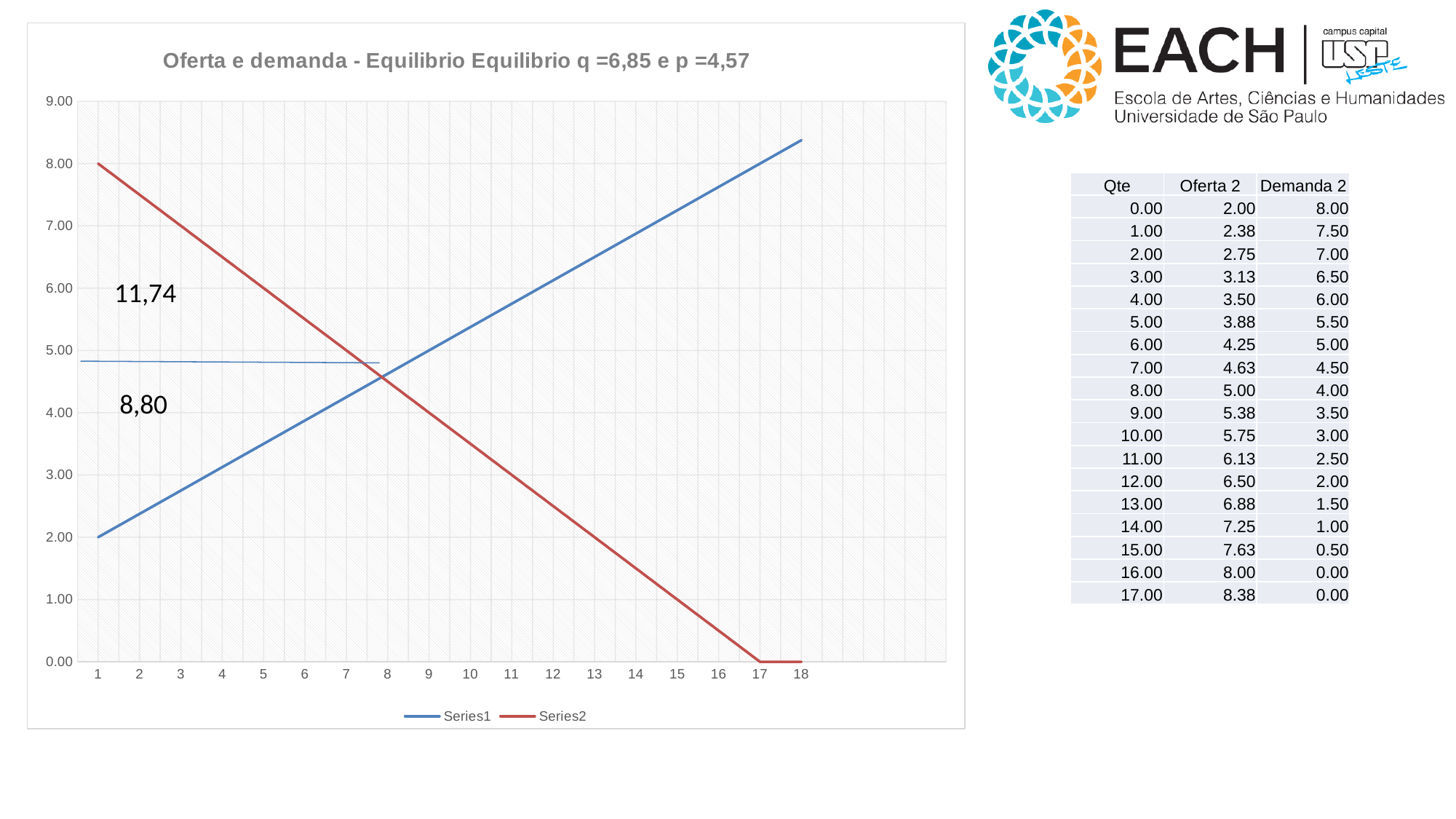
How many points are labelled along the x axis of the chart? 18 Does Series2 rise or fall as the x axis increases? fall What is the value of Series2 at x = 1? 8.00 At x = 3, which series has the larger value, Series1 or Series2? Series2 Is the value of Series1 at x = 14 greater or less than 6.00? greater What is the value of Series1 at x = 1? 2.00 What kind of chart is shown on the slide? line chart How many series does the chart legend list? 2 What is the title of the chart? Oferta e demanda - Equilibrio Equilibrio q =6,85 e p =4,57 What is the value of Series2 at x = 18? 0.00 Is the value of Series2 at x = 12 greater or less than 3.00? less Does Series1 rise or fall as the x axis increases? rise